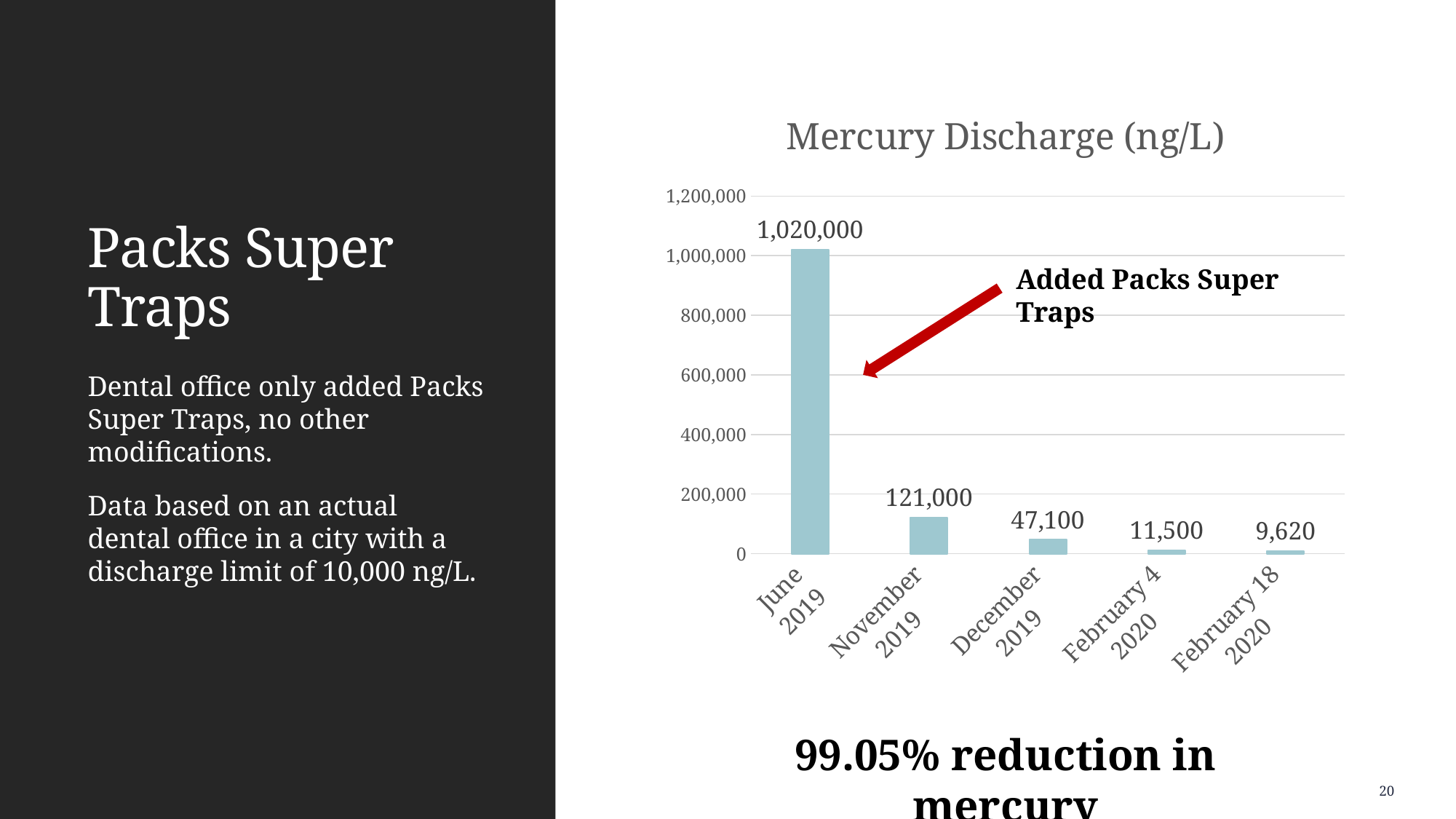
Do the values rise or fall from left to right along the x axis? Fall What is the mercury discharge value for December 2019? 47,100 How many categories are shown on the x axis of the chart? 5 What is the difference between the mercury discharge for June 2019 and November 2019? 899,000 What is the difference between the mercury discharge for February 4 2020 and February 18 2020? 1,880 What is the mercury discharge value for June 2019? 1,020,000 Which category has the highest mercury discharge? June 2019 What is the mercury discharge value for February 18 2020? 9,620 Which category has the lowest mercury discharge? February 18 2020 What is the mercury discharge value for November 2019? 121,000 What kind of chart is shown on the slide? Bar chart Which is larger, the mercury discharge for December 2019 or February 4 2020? December 2019